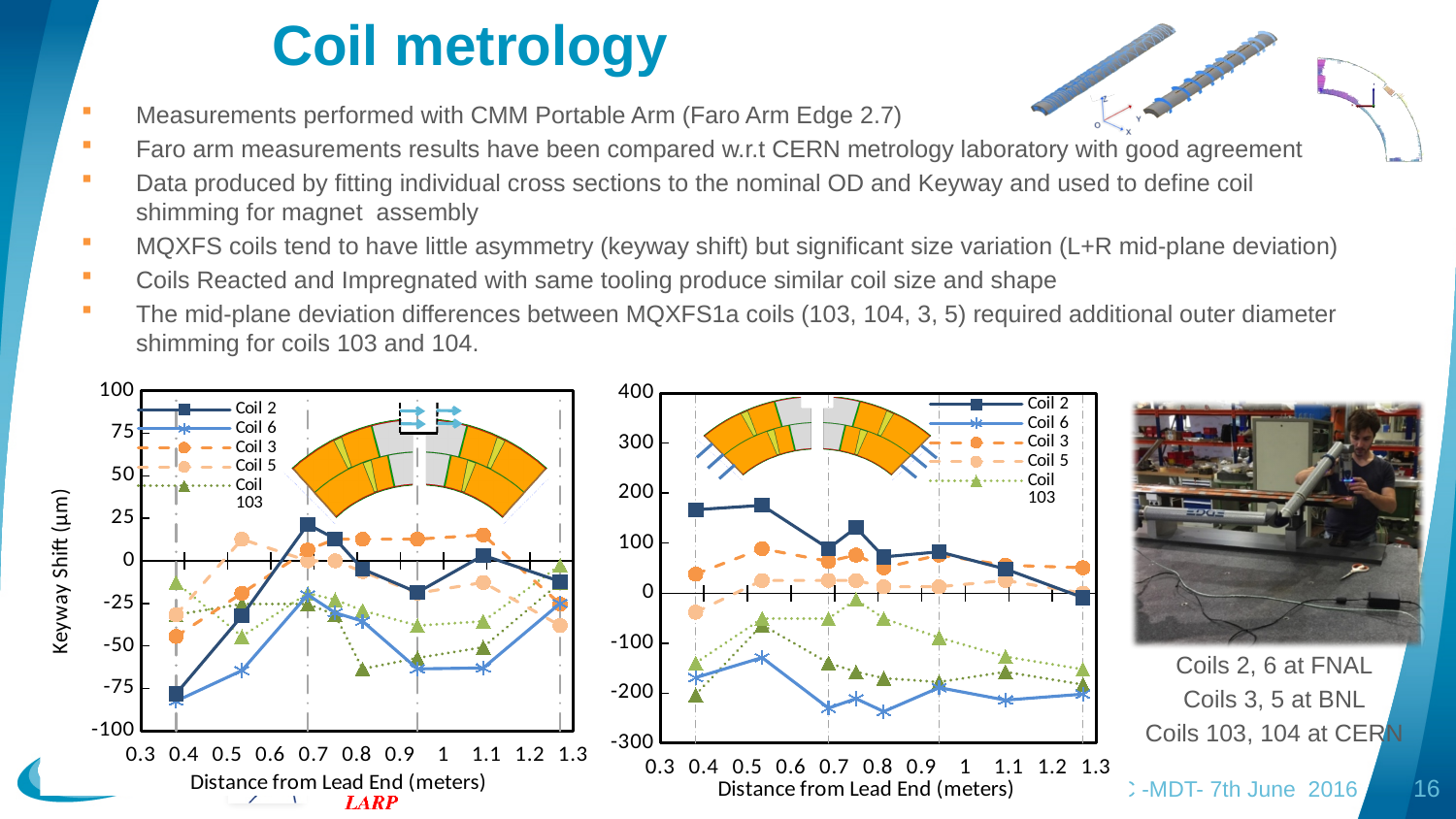
How many series does the legend of the right chart list? 5 In the right chart, which series has the highest value at 0.4 meters? Coil 2 In the left chart, is the value for Coil 2 at 0.7 meters greater or less than 0? greater What is the y-axis title of the left chart? Keyway Shift (µm) In the right chart, does the Coil 2 series rise or fall overall from 0.4 to 1.3 meters? fall In the left chart, which is larger at 0.9 meters, Coil 3 or Coil 6? Coil 3 In the left chart, is the value for Coil 6 at 0.9 meters greater or less than -50? less In the left chart, is the value for Coil 2 at 0.4 meters greater or less than -50? less What is the x-axis title of the right chart? Distance from Lead End (meters) What kind of chart is the left chart on the slide? line chart